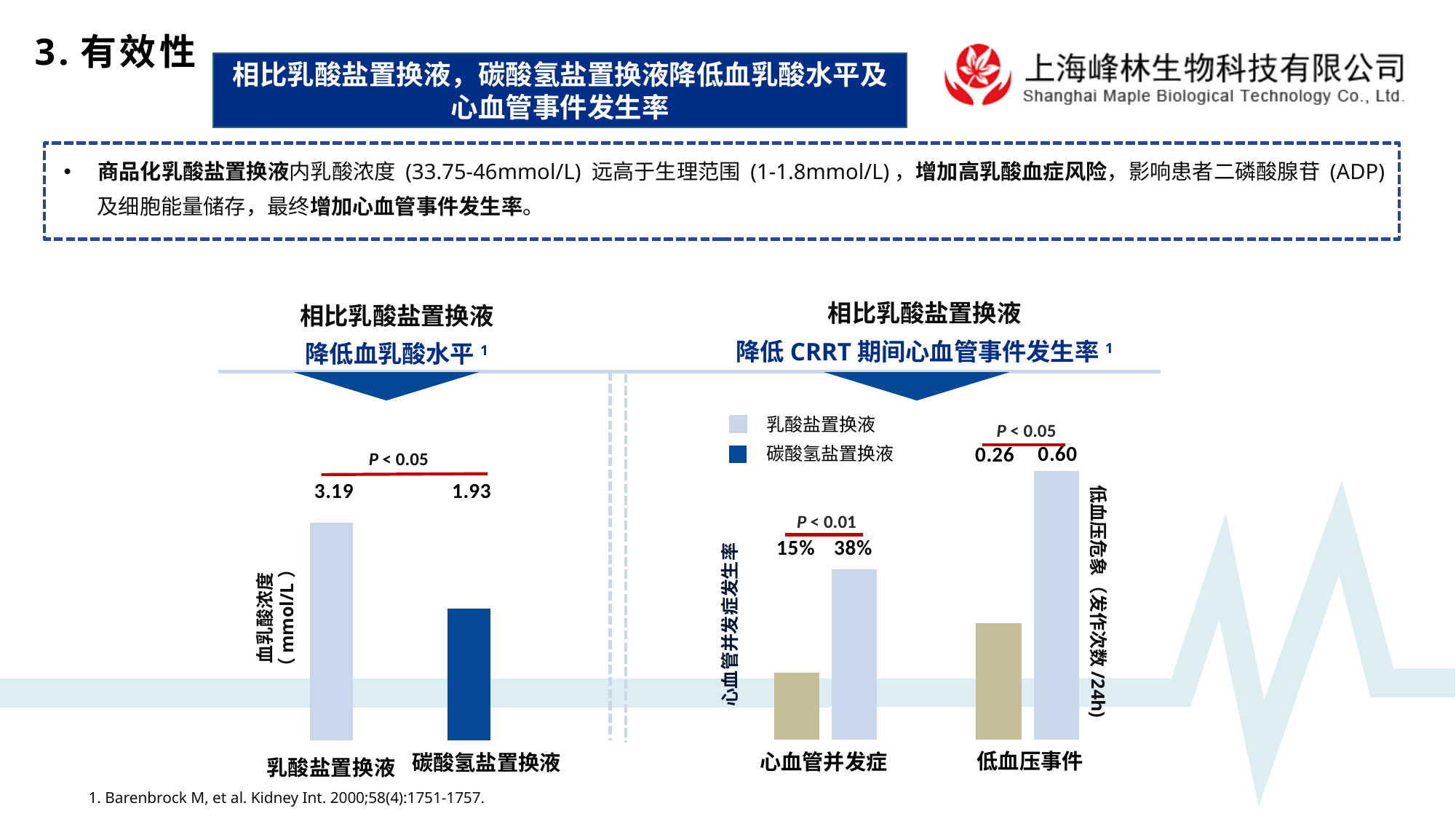
In the right chart (降低 CRRT 期间心血管事件发生率), what P value is shown above the 心血管并发症 bars? P < 0.01 In the left chart (降低血乳酸水平), what is the blood lactate concentration for 碳酸氢盐置换液? 1.93 In the right chart (降低 CRRT 期间心血管事件发生率), what is the 低血压事件 value for 乳酸盐置换液 (the light blue bar)? 0.60 In the right chart (降低 CRRT 期间心血管事件发生率), how many categories are shown on the x axis? 2 In the left chart (降低血乳酸水平), what is the difference between the values for 乳酸盐置换液 and 碳酸氢盐置换液? 1.26 In the right chart (降低 CRRT 期间心血管事件发生率), what are the two values labelled above the 心血管并发症 bars? 15% and 38% In the left chart (降低血乳酸水平), what kind of chart is shown? bar chart In the right chart (降低 CRRT 期间心血管事件发生率), what is the 心血管并发症 rate for 乳酸盐置换液 (the light blue bar)? 38% In the left chart (降低血乳酸水平), what is the unit shown on the y-axis label? mmol/L In the left chart (降低血乳酸水平), what is the blood lactate concentration for 乳酸盐置换液? 3.19 In the left chart (降低血乳酸水平), which replacement fluid has the higher blood lactate concentration? 乳酸盐置换液 In the right chart (降低 CRRT 期间心血管事件发生率), how many series does the legend list? 2